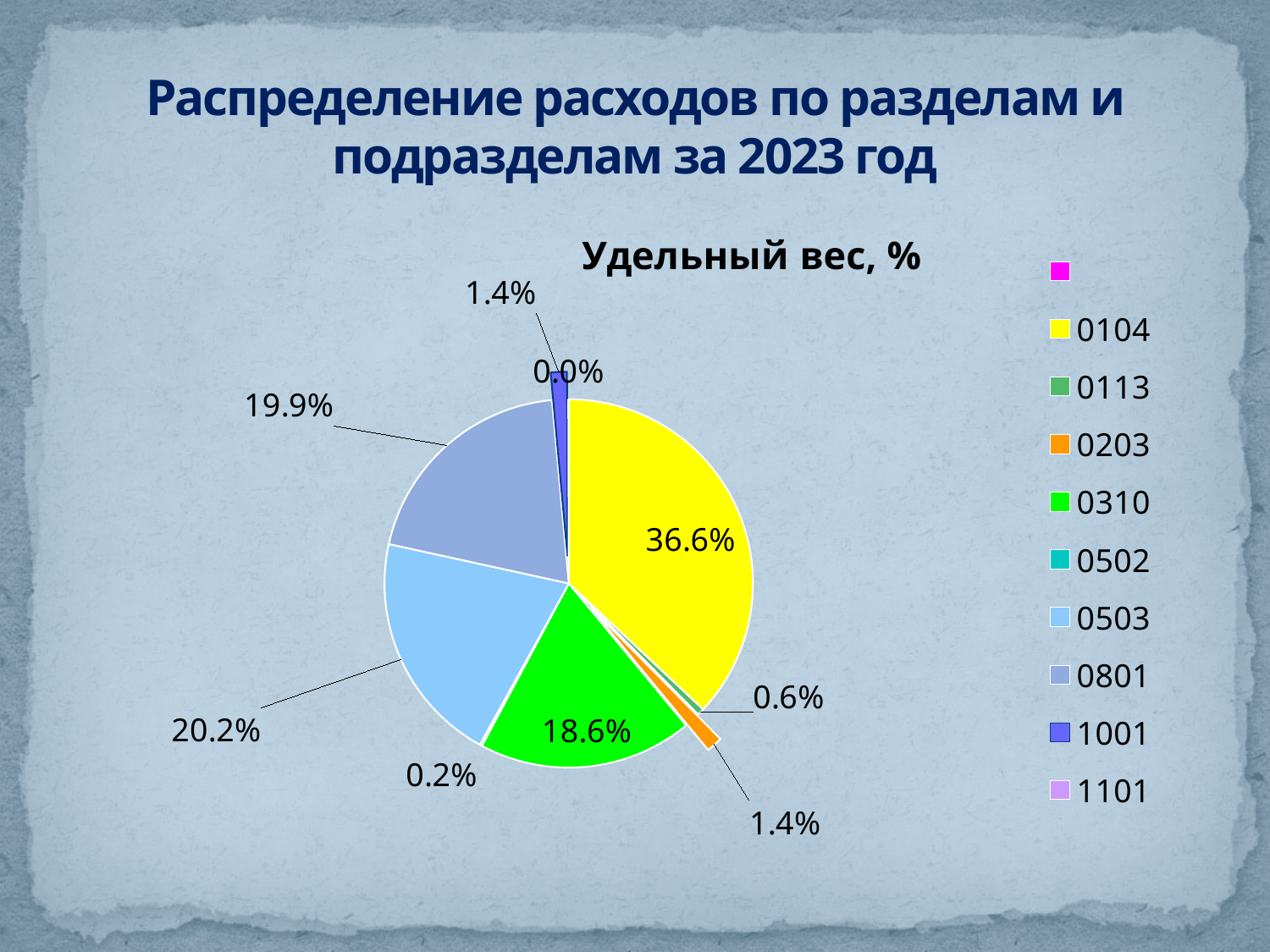
What is the title of the chart? Удельный вес, % What share does category 0104 have in the pie chart? 36.6% What share does category 0203 have in the pie chart? 1.4% What share does category 0801 have in the pie chart? 19.9% What share does category 0310 have in the pie chart? 18.6% What share does category 0113 have in the pie chart? 0.6% What is the difference between the shares of 0104 and 0310? 18.0% What colour is the slice for category 0104? yellow What share does category 0503 have in the pie chart? 20.2% Which category has the largest share of the pie? 0104 What type of chart is shown on the slide? pie chart Which is larger, the share of 0503 or the share of 0801? 0503